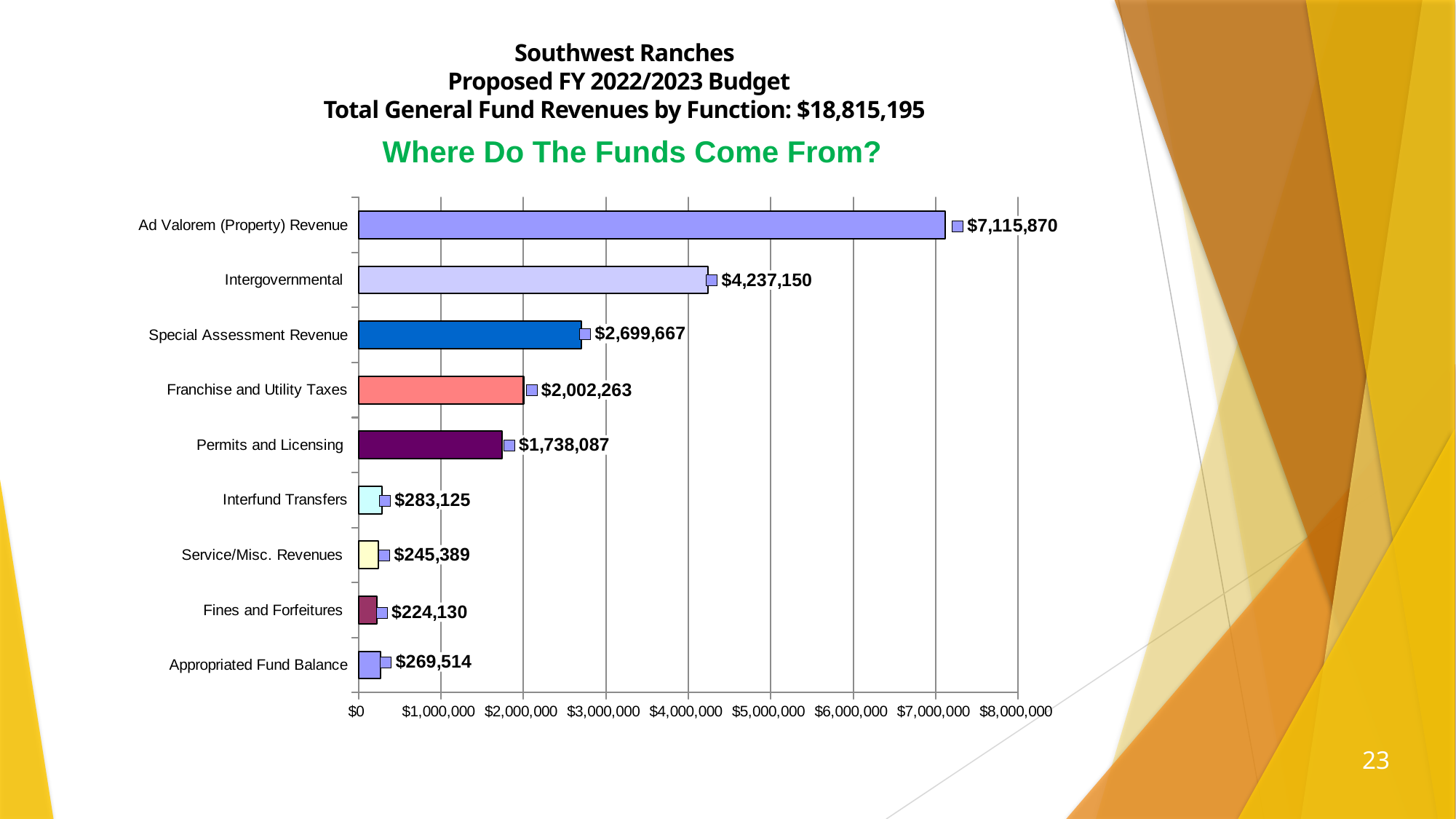
What is the value for Permits and Licensing? $1,738,087 Which category has the lowest value? Fines and Forfeitures What is the green heading above the chart? Where Do The Funds Come From? What is the difference between Special Assessment Revenue and Franchise and Utility Taxes? $697,404 Which is larger, Interfund Transfers or Service/Misc. Revenues? Interfund Transfers What is the value for Ad Valorem (Property) Revenue? $7,115,870 How many categories are shown in the chart? 9 Which category has the highest value? Ad Valorem (Property) Revenue Is the value for Intergovernmental greater or less than $4,000,000? greater What is the value for Fines and Forfeitures? $224,130 What kind of chart is shown on the slide? bar chart What is the value for Intergovernmental? $4,237,150